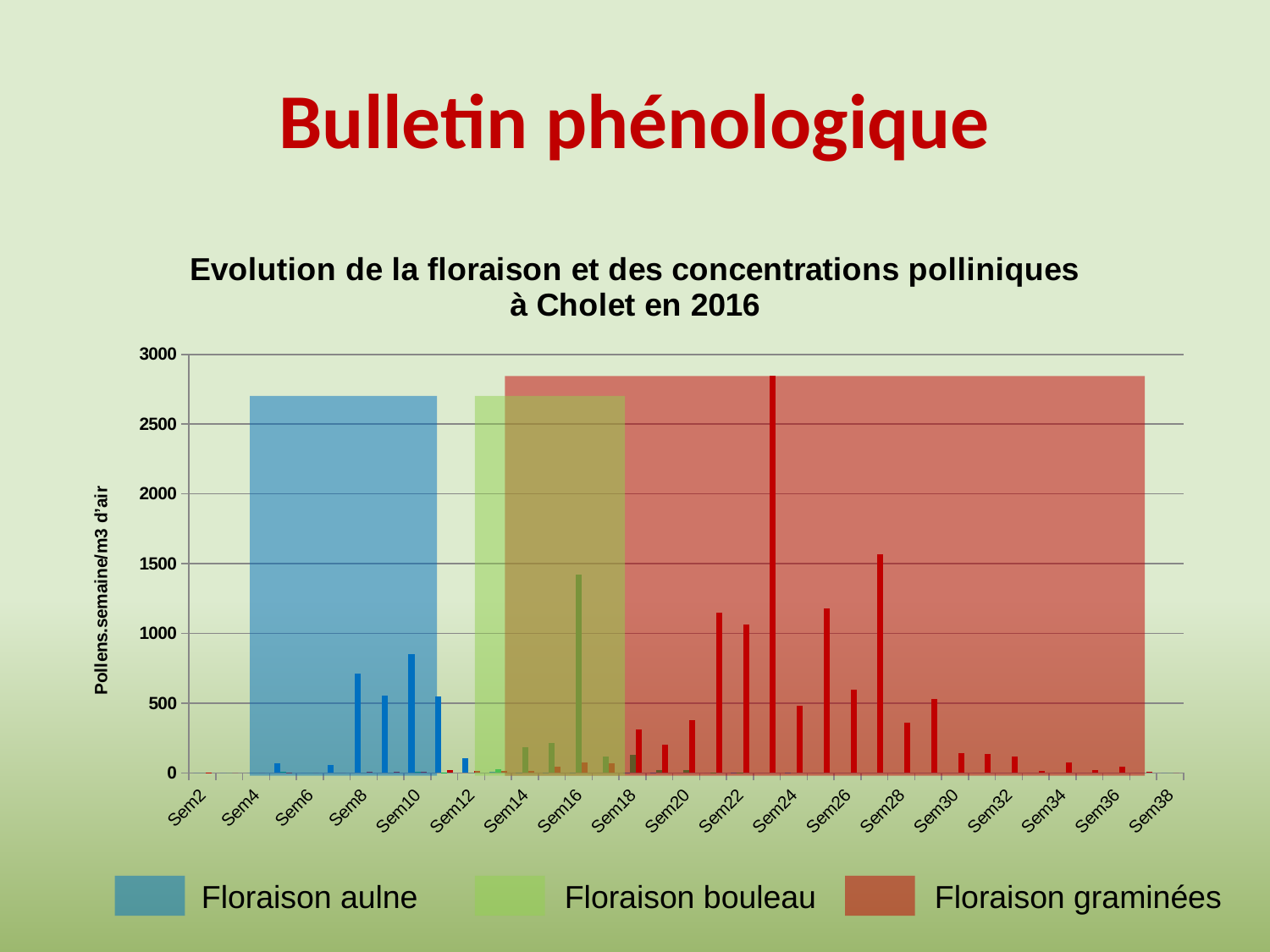
Which colour of bars reaches the highest value in the chart: blue, green or red? red Is the tallest bar in the chart greater or less than 2500? greater Which is taller: the tallest blue bar or the tallest green bar? the tallest green bar What is the highest value shown on the vertical axis of the chart? 3000 How many entries does the legend below the chart list? 3 Is the tallest green bar in the chart greater or less than 1500? less What kind of chart is shown on the slide? bar chart Is the tallest blue bar in the chart greater or less than 1000? less Which is taller: the tallest red bar or the tallest green bar? the tallest red bar What label is shown on the vertical axis of the chart? Pollens.semaine/m3 d'air What is the title of the chart? Evolution de la floraison et des concentrations polliniques à Cholet en 2016